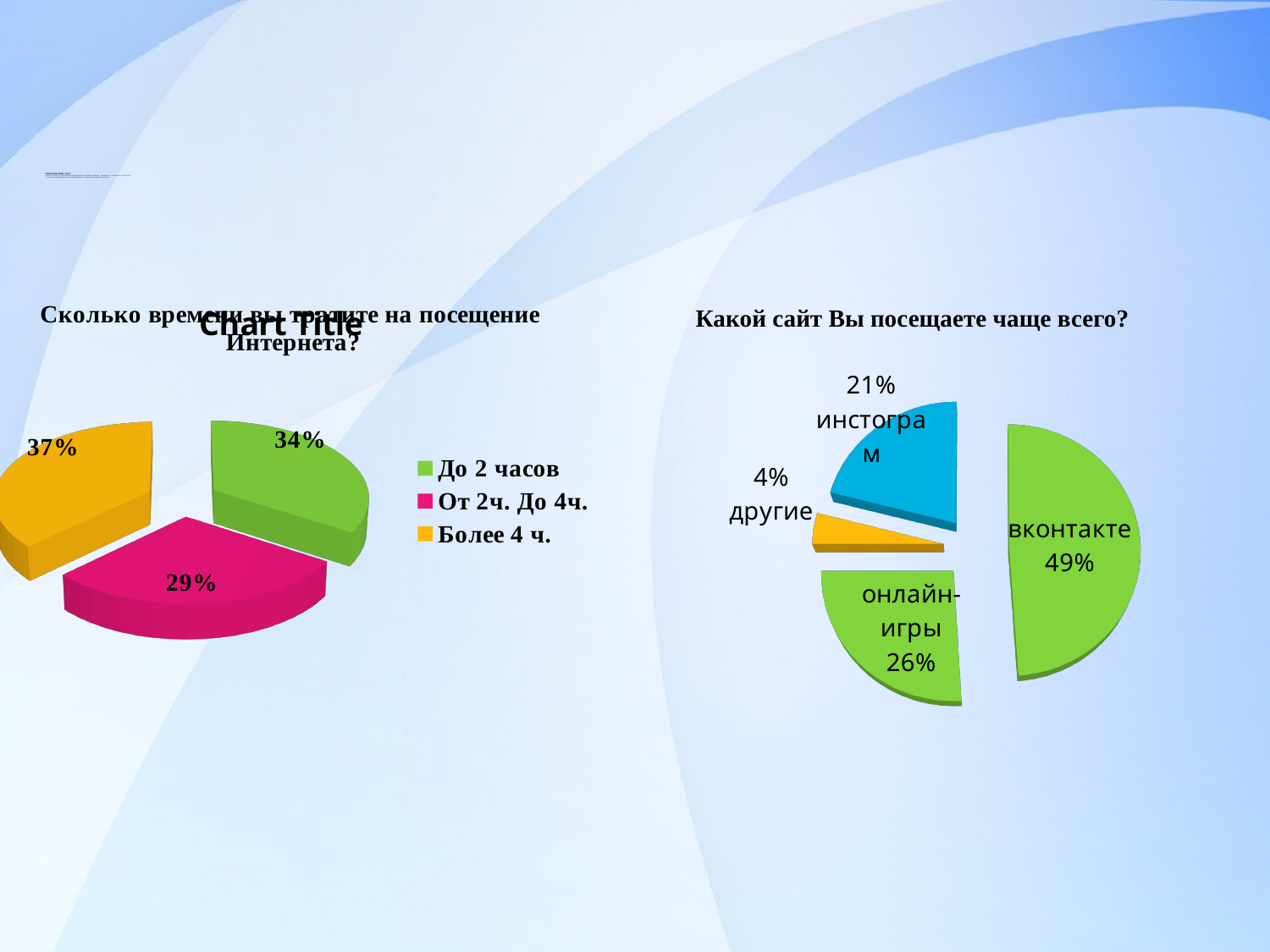
In the left chart (Сколько времени вы тратите на посещение Интернета?), what percentage is shown for 'До 2 часов'? 34% In the left chart (Сколько времени вы тратите на посещение Интернета?), what colour is the slice for 'От 2ч. До 4ч.'? Pink In the left chart (Сколько времени вы тратите на посещение Интернета?), which category has the largest share? Более 4 ч. In the right chart (Какой сайт Вы посещаете чаще всего?), what percentage is shown for 'онлайн-игры'? 26% What type of chart is the right chart (Какой сайт Вы посещаете чаще всего?)? Pie chart In the right chart (Какой сайт Вы посещаете чаще всего?), what is the difference between the shares for 'вконтакте' and 'инстограм'? 28% In the right chart (Какой сайт Вы посещаете чаще всего?), what percentage is shown for 'вконтакте'? 49% In the left chart (Сколько времени вы тратите на посещение Интернета?), which category has the smallest share? От 2ч. До 4ч. In the right chart (Какой сайт Вы посещаете чаще всего?), which category has the smallest share? другие In the right chart (Какой сайт Вы посещаете чаще всего?), how many slices does the pie have? 4 In the left chart (Сколько времени вы тратите на посещение Интернета?), how many entries does the legend list? 3 In the left chart (Сколько времени вы тратите на посещение Интернета?), what percentage is shown for 'Более 4 ч.'? 37%